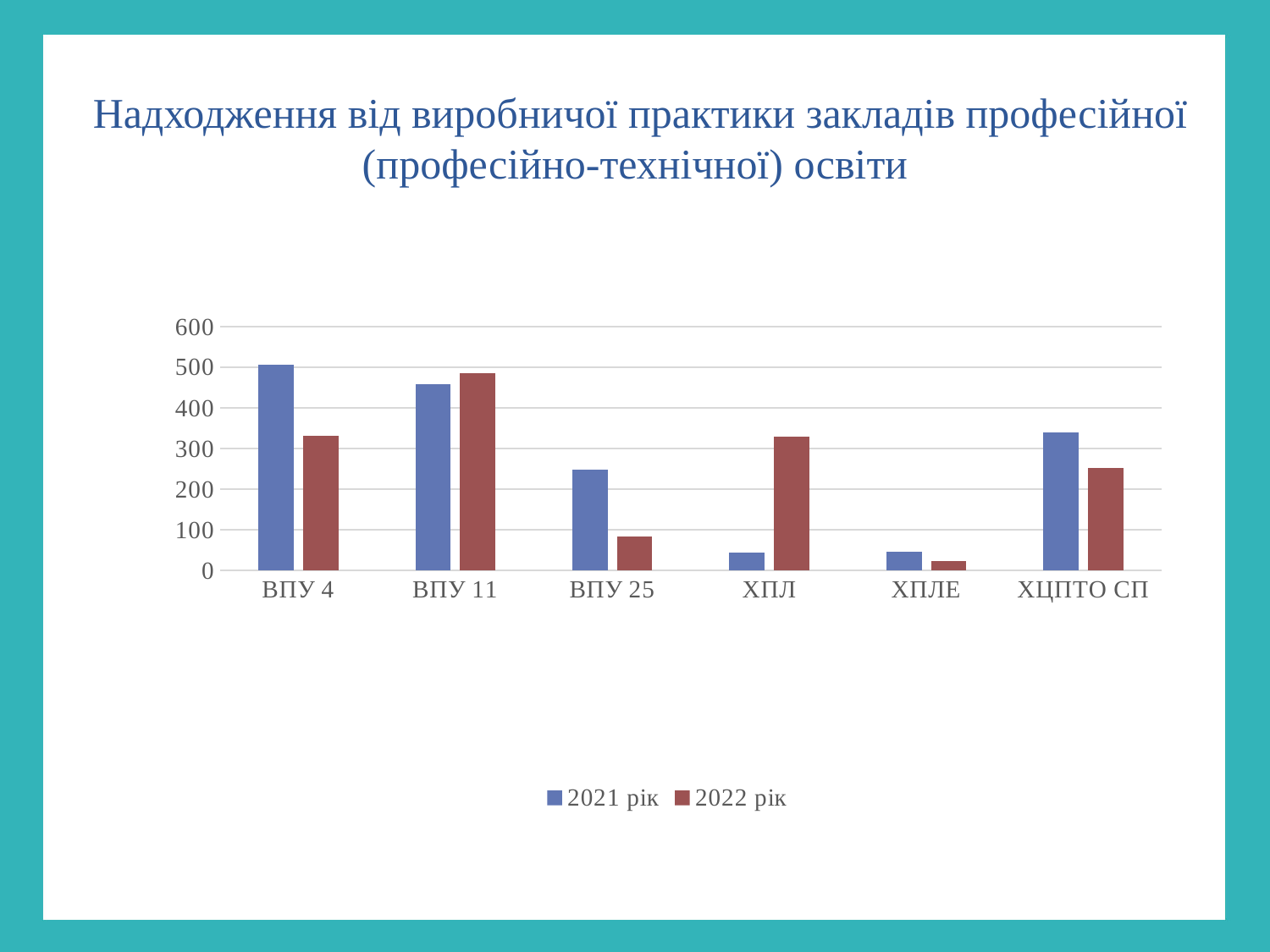
Is the value for ХЦПТО СП in the 2022 рік series greater or less than 200? greater How many categories are shown on the x axis of the chart? 6 Which category has the highest value for the 2021 рік series? ВПУ 4 What are the two series listed in the chart legend? 2021 рік and 2022 рік Which category has the highest value for the 2022 рік series? ВПУ 11 Is the value for ВПУ 4 in the 2021 рік series greater or less than 400? greater For ХПЛ, which series has the larger value, 2021 рік or 2022 рік? 2022 рік Is the value for ХПЛЕ in the 2021 рік series greater or less than 100? less Which category has the lowest value for the 2022 рік series? ХПЛЕ For ВПУ 25, which series has the larger value, 2021 рік or 2022 рік? 2021 рік What kind of chart is shown on the slide? bar chart How many series does the legend list? 2